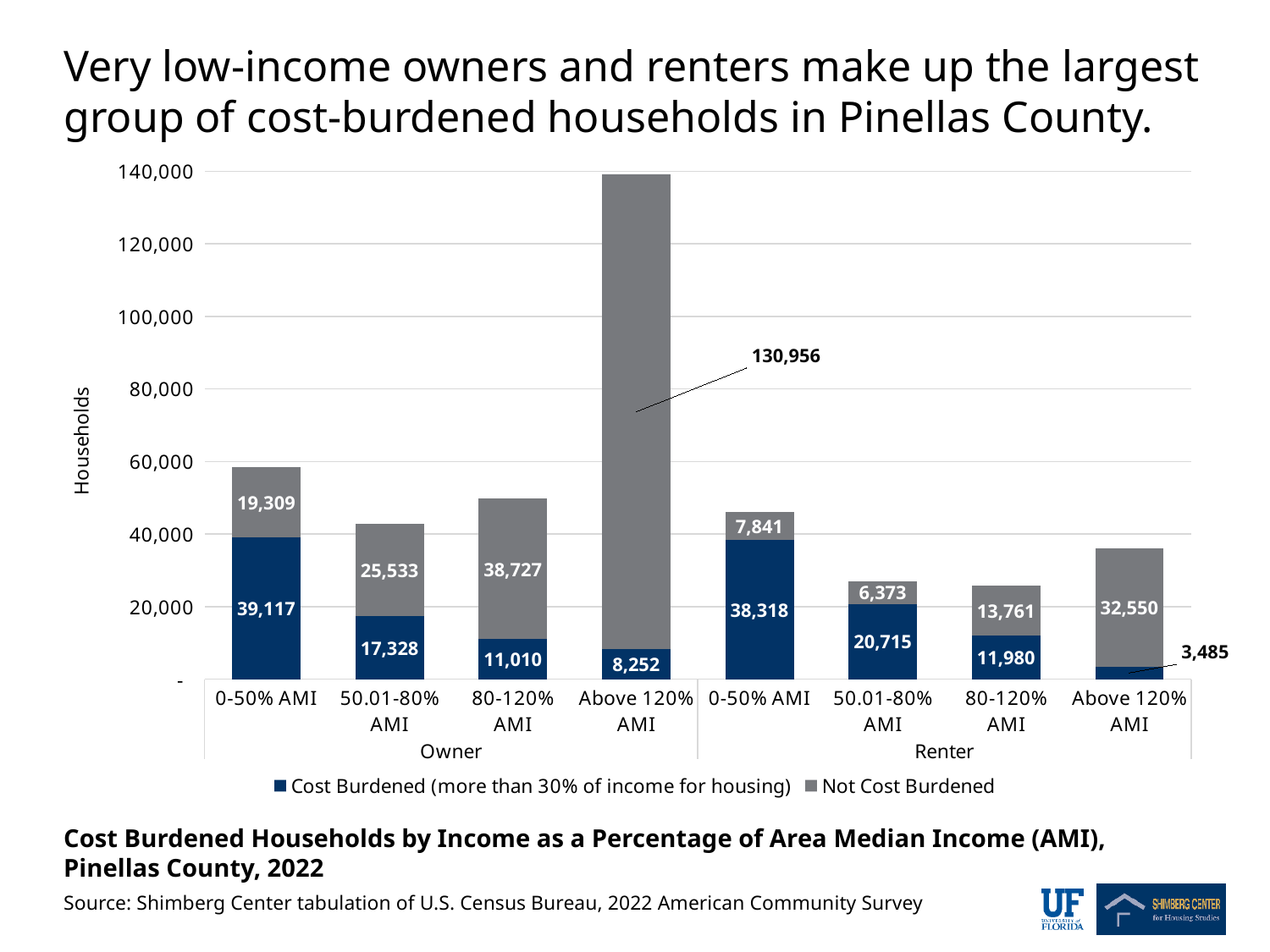
What is the total number of owner households in the 0-50% AMI category (cost burdened plus not cost burdened)? 58,426 What is the difference between cost-burdened owner households and cost-burdened renter households in the 0-50% AMI category? 799 What is the number of cost-burdened renter households in the 50.01-80% AMI category? 20,715 What is the number of cost-burdened owner households in the 0-50% AMI category? 39,117 Which category has the highest number of not cost-burdened households? Owner, Above 120% AMI How many series does the legend list? 2 Which category has the lowest number of cost-burdened households? Renter, Above 120% AMI What is the number of not cost-burdened renter households in the 80-120% AMI category? 13,761 Which is larger: the number of cost-burdened renter households at 80-120% AMI or the number of cost-burdened owner households at 80-120% AMI? Renter, 80-120% AMI (11,980) What is the number of not cost-burdened owner households in the Above 120% AMI category? 130,956 What is the total number of renter households in the 0-50% AMI category (cost burdened plus not cost burdened)? 46,159 What kind of chart is shown on the slide? Stacked bar chart